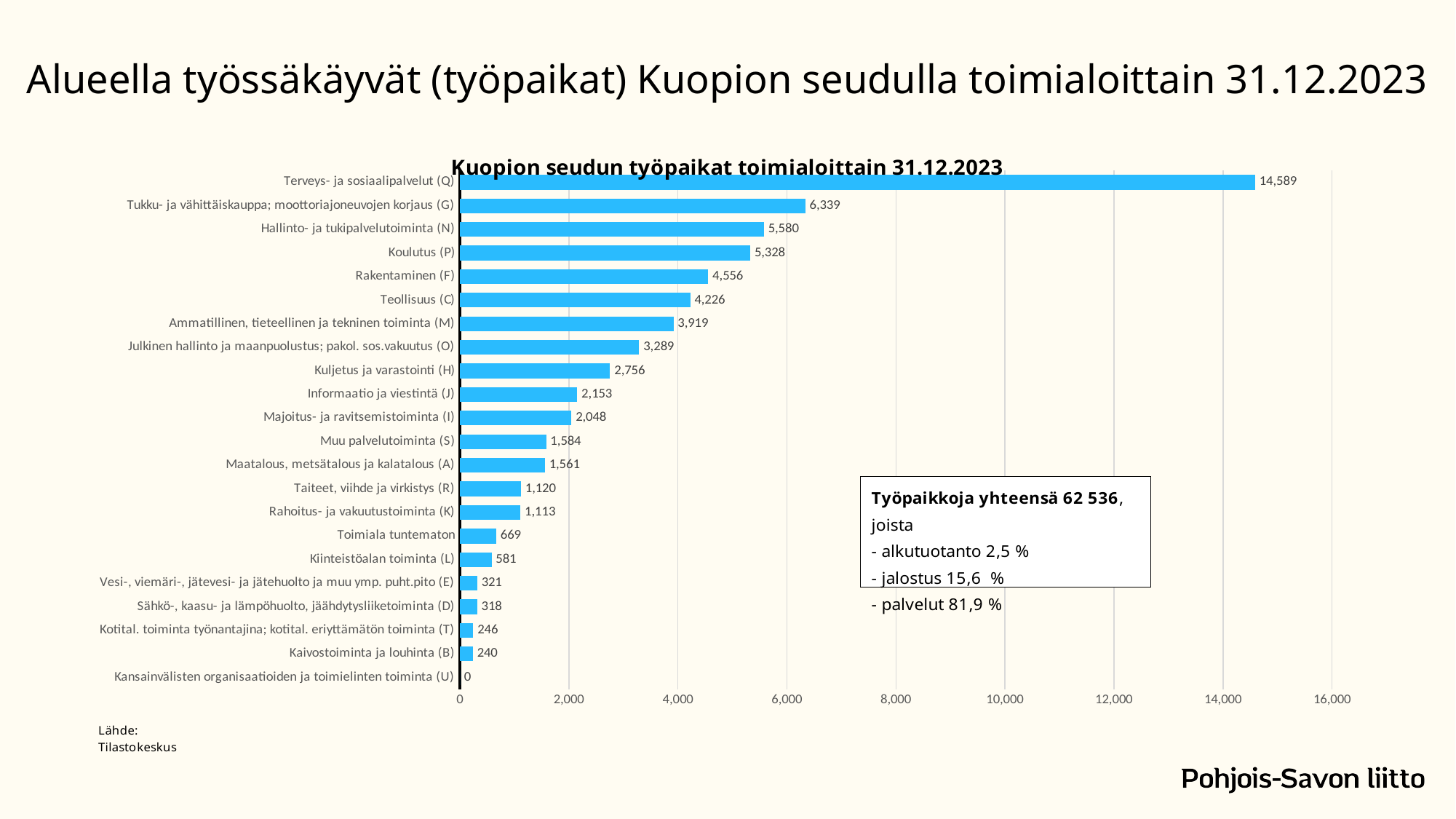
Which is larger, Hallinto- ja tukipalvelutoiminta (N) or Rakentaminen (F)? Hallinto- ja tukipalvelutoiminta (N) How many categories are shown in the chart? 22 What is the difference between Terveys- ja sosiaalipalvelut (Q) and Tukku- ja vähittäiskauppa; moottoriajoneuvojen korjaus (G)? 8,250 What is the value for Terveys- ja sosiaalipalvelut (Q)? 14,589 Which category has the highest value? Terveys- ja sosiaalipalvelut (Q) What is the title of the chart? Kuopion seudun työpaikat toimialoittain 31.12.2023 What is the value for Koulutus (P)? 5,328 What is the value for Kuljetus ja varastointi (H)? 2,756 What is the value for Kaivostoiminta ja louhinta (B)? 240 Which category has the lowest value? Kansainvälisten organisaatioiden ja toimielinten toiminta (U) What kind of chart is shown on the slide? bar chart What is the difference between Rakentaminen (F) and Teollisuus (C)? 330